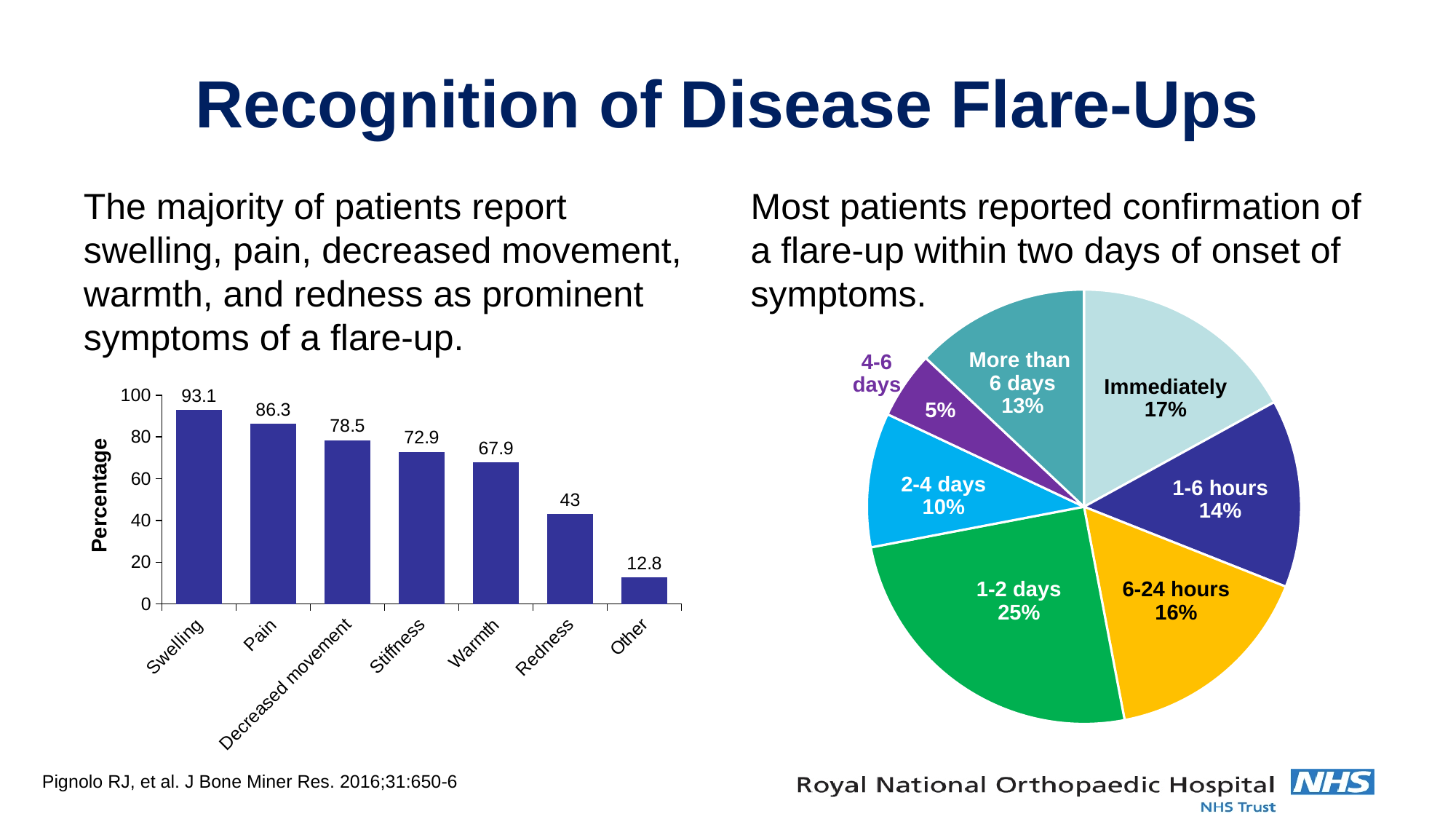
In the pie chart on the right, which category has the smallest slice? 4-6 days In the bar chart on the left, which symptom has the lowest percentage? Other In the pie chart on the right, what share of patients reported confirmation of a flare-up within 1-2 days? 25% In the bar chart on the left, do the values rise or fall from Swelling to Other along the x axis? fall In the bar chart on the left, what is the difference between the percentages for Pain and Stiffness? 13.4 In the bar chart on the left, which symptom has the highest percentage? Swelling In the pie chart on the right, how many slices are there? 7 In the pie chart on the right, which is larger: the slice for Immediately or the slice for 6-24 hours? Immediately What kind of chart is shown on the left of the slide? bar chart In the bar chart on the left, how many symptom categories are shown? 7 In the bar chart on the left, what is the percentage for Redness? 43 In the bar chart on the left, what is the percentage for Swelling? 93.1